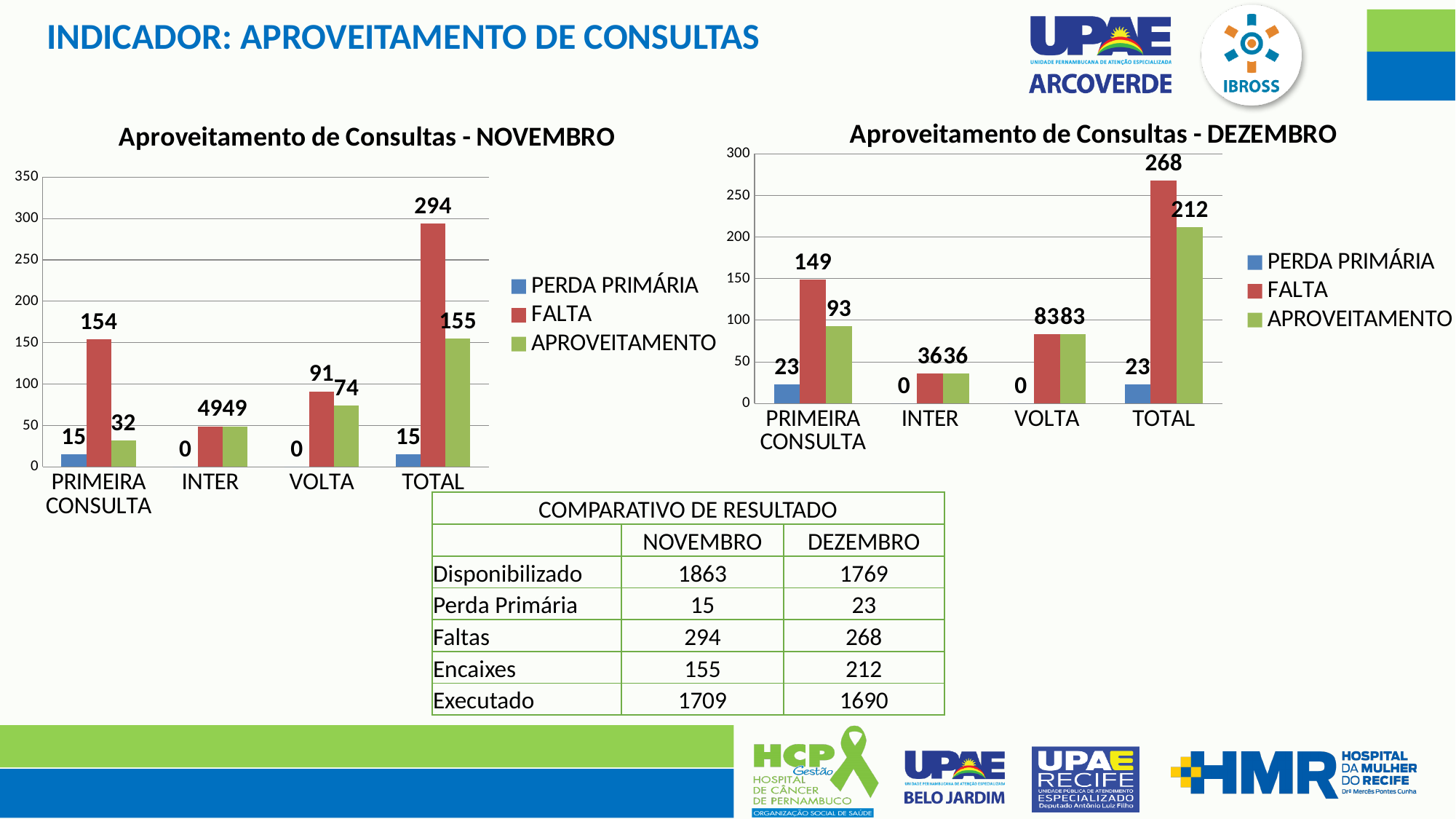
In the 'Aproveitamento de Consultas - DEZEMBRO' chart, what is the PERDA PRIMÁRIA value for PRIMEIRA CONSULTA? 23 In the 'Aproveitamento de Consultas - DEZEMBRO' chart, which category has the lowest FALTA value? INTER In the 'Aproveitamento de Consultas - NOVEMBRO' chart, what is the difference between the FALTA and APROVEITAMENTO values for TOTAL? 139 In the 'Aproveitamento de Consultas - NOVEMBRO' chart, is the FALTA value for TOTAL greater or less than 250? greater In the 'Aproveitamento de Consultas - NOVEMBRO' chart, what is the APROVEITAMENTO value for VOLTA? 74 In the 'Aproveitamento de Consultas - NOVEMBRO' chart, what is the FALTA value for PRIMEIRA CONSULTA? 154 How many series does the legend of the 'Aproveitamento de Consultas - NOVEMBRO' chart list? 3 In the 'Aproveitamento de Consultas - DEZEMBRO' chart, what is the APROVEITAMENTO value for TOTAL? 212 How many categories are shown on the x axis of the 'Aproveitamento de Consultas - DEZEMBRO' chart? 4 What kind of chart is 'Aproveitamento de Consultas - DEZEMBRO'? Bar chart In the 'Aproveitamento de Consultas - NOVEMBRO' chart, which category has the highest FALTA value? TOTAL In the 'Aproveitamento de Consultas - DEZEMBRO' chart, which is larger for PRIMEIRA CONSULTA: FALTA or APROVEITAMENTO? FALTA